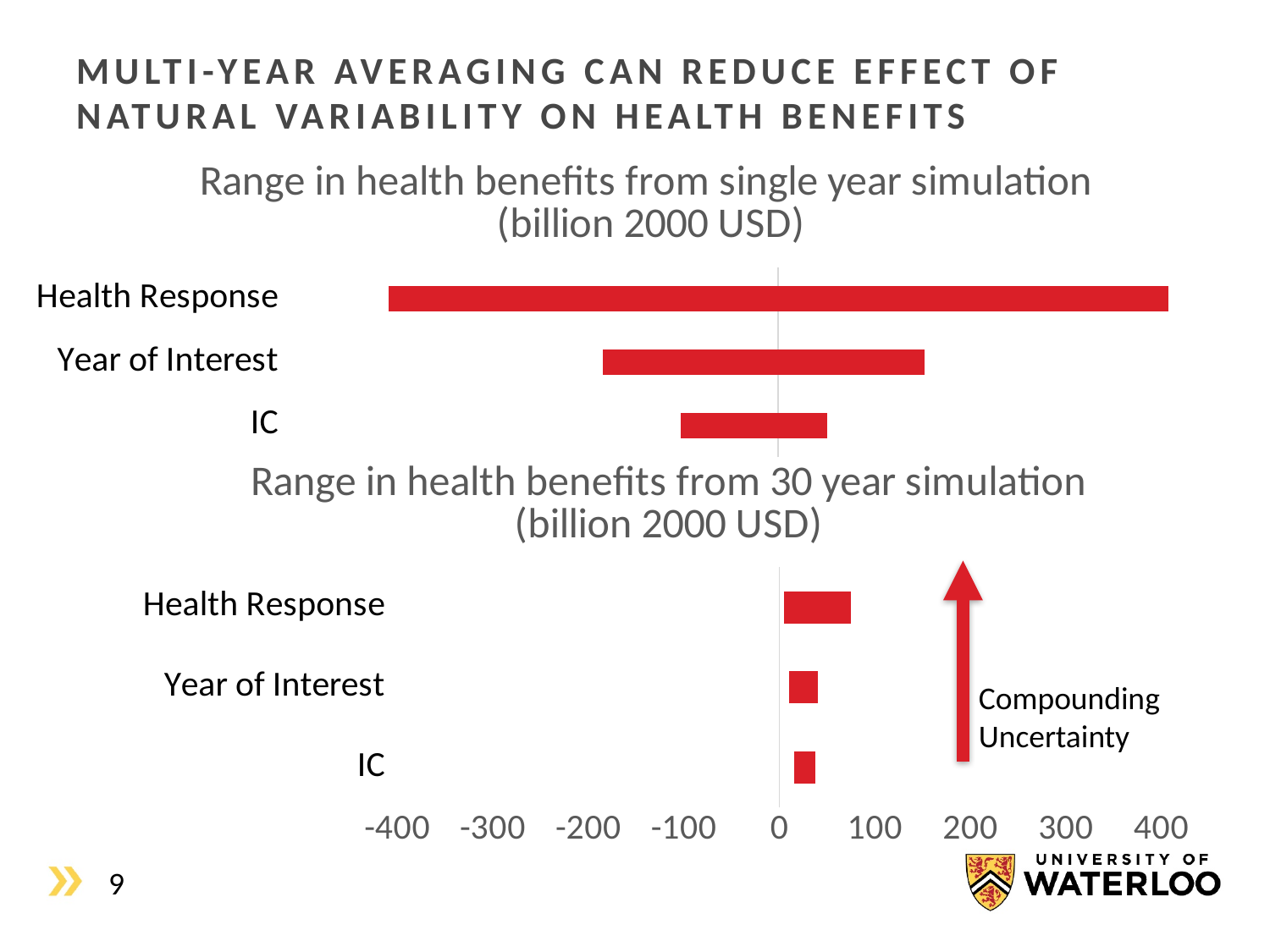
In the 'Range in health benefits from 30 year simulation' chart, is the upper end of the Health Response bar greater or less than 100? less In the 'Range in health benefits from single year simulation' chart, is the upper end of the Year of Interest bar greater or less than 100? greater How many categories are shown in the 'Range in health benefits from 30 year simulation' chart? 3 In the 'Range in health benefits from single year simulation' chart, is the lower end of the Year of Interest bar greater or less than -100? less What kind of chart is the 'Range in health benefits from single year simulation' chart? bar chart In the 'Range in health benefits from 30 year simulation' chart, which category has the widest range? Health Response In the 'Range in health benefits from single year simulation' chart, which category has the narrowest range? IC What label is written next to the upward arrow beside the 'Range in health benefits from 30 year simulation' chart? Compounding Uncertainty In the 'Range in health benefits from single year simulation' chart, which category has the widest range? Health Response In the 'Range in health benefits from single year simulation' chart, which has the wider range, Year of Interest or IC? Year of Interest What unit is given in the titles of both charts? billion 2000 USD